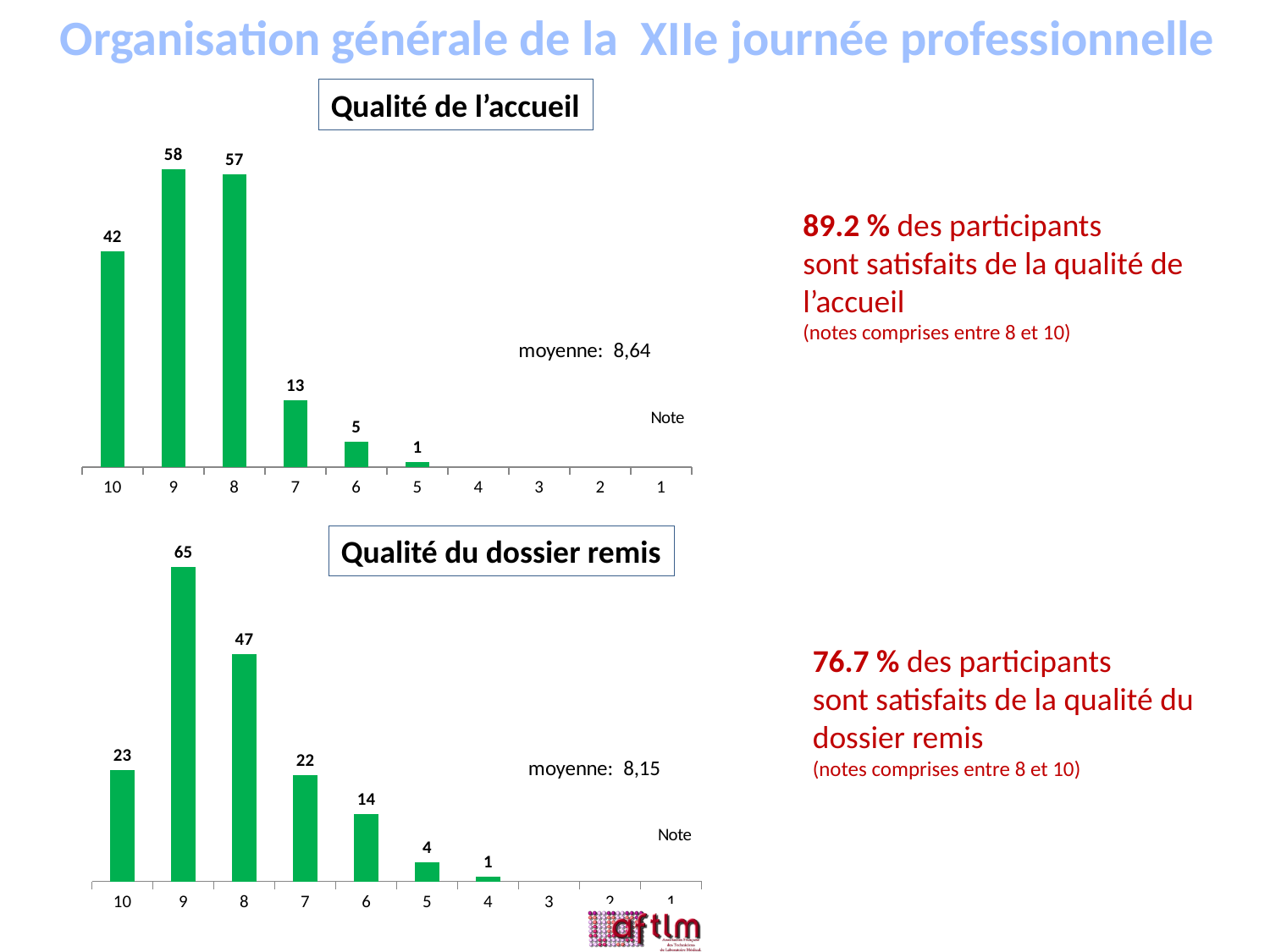
In the 'Qualité du dossier remis' chart, which is larger, the value for note 10 or the value for note 7? note 10 In the 'Qualité de l'accueil' chart, which note has the highest value? 9 In the 'Qualité de l'accueil' chart, what is the average (moyenne) shown? 8,64 In the 'Qualité de l'accueil' chart, what is the value for note 10? 42 In the 'Qualité du dossier remis' chart, what is the value for note 6? 14 In the 'Qualité du dossier remis' chart, what is the value for note 8? 47 What kind of chart is the 'Qualité du dossier remis' chart? bar chart In the 'Qualité du dossier remis' chart, which note has the highest value? 9 In the 'Qualité du dossier remis' chart, what is the difference between the values for note 9 and note 8? 18 In the 'Qualité de l'accueil' chart, what is the value for note 7? 13 In the 'Qualité de l'accueil' chart, what is the difference between the values for note 9 and note 10? 16 How many note categories are shown on the x axis of the 'Qualité de l'accueil' chart? 10